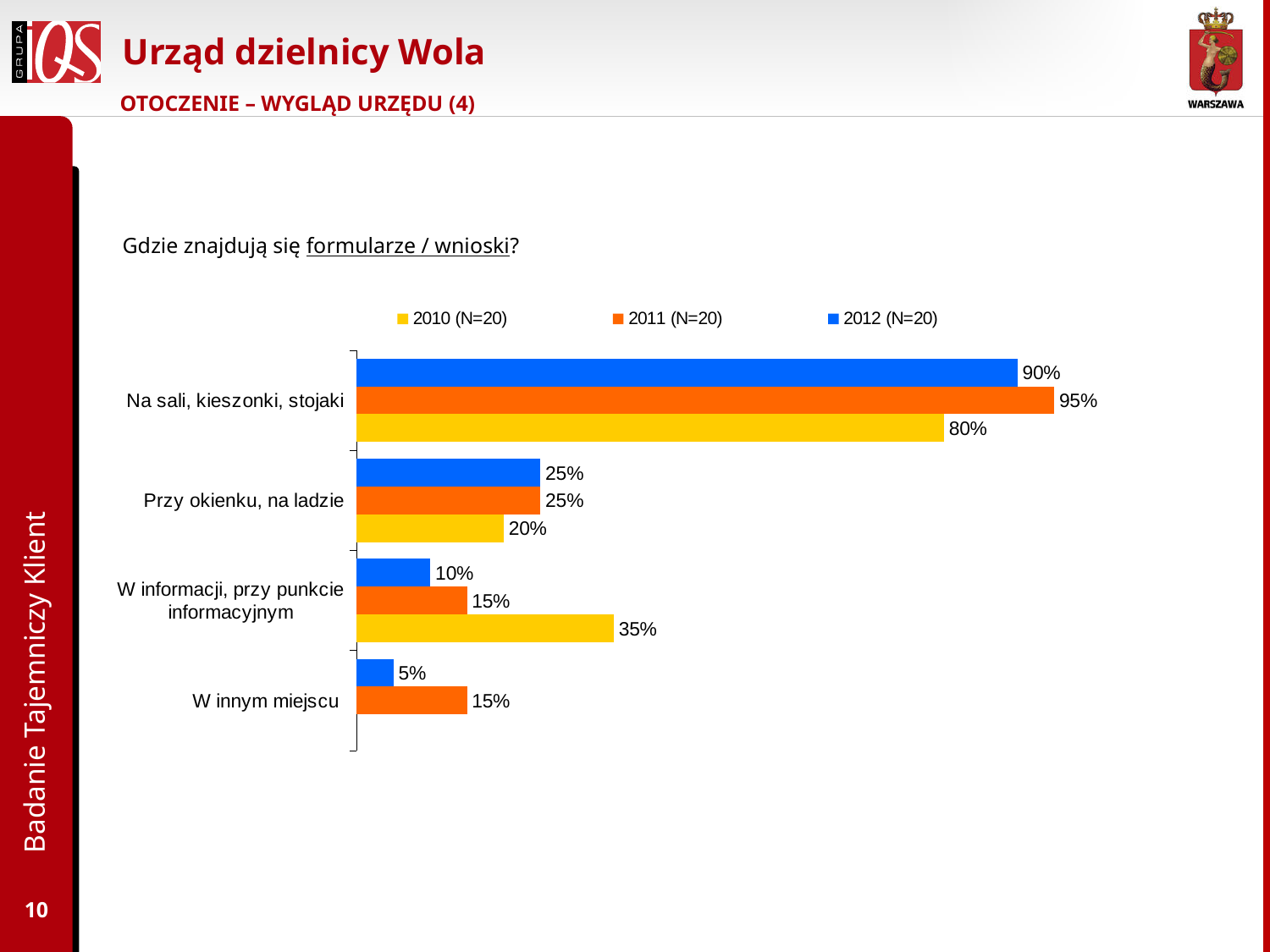
What value is shown for 'Na sali, kieszonki, stojaki' in the 2011 (N=20) series? 95% What kind of chart is shown on the slide? Bar chart Which category has the highest value in the 2012 (N=20) series? Na sali, kieszonki, stojaki Which category has the lowest value in the 2012 (N=20) series? W innym miejscu What value is shown for 'W informacji, przy punkcie informacyjnym' in the 2010 (N=20) series? 35% What is the difference between the 2010 (N=20) and 2012 (N=20) values for 'W informacji, przy punkcie informacyjnym'? 25% What is the difference between the 2011 (N=20) and 2010 (N=20) values for 'Na sali, kieszonki, stojaki'? 15% What value is shown for 'W innym miejscu' in the 2012 (N=20) series? 5% Which is larger for 'Przy okienku, na ladzie': the 2010 (N=20) value or the 2012 (N=20) value? 2012 (N=20) How many series does the legend list? 3 Which colour represents the 2011 (N=20) series? Orange How many categories are shown on the chart? 4